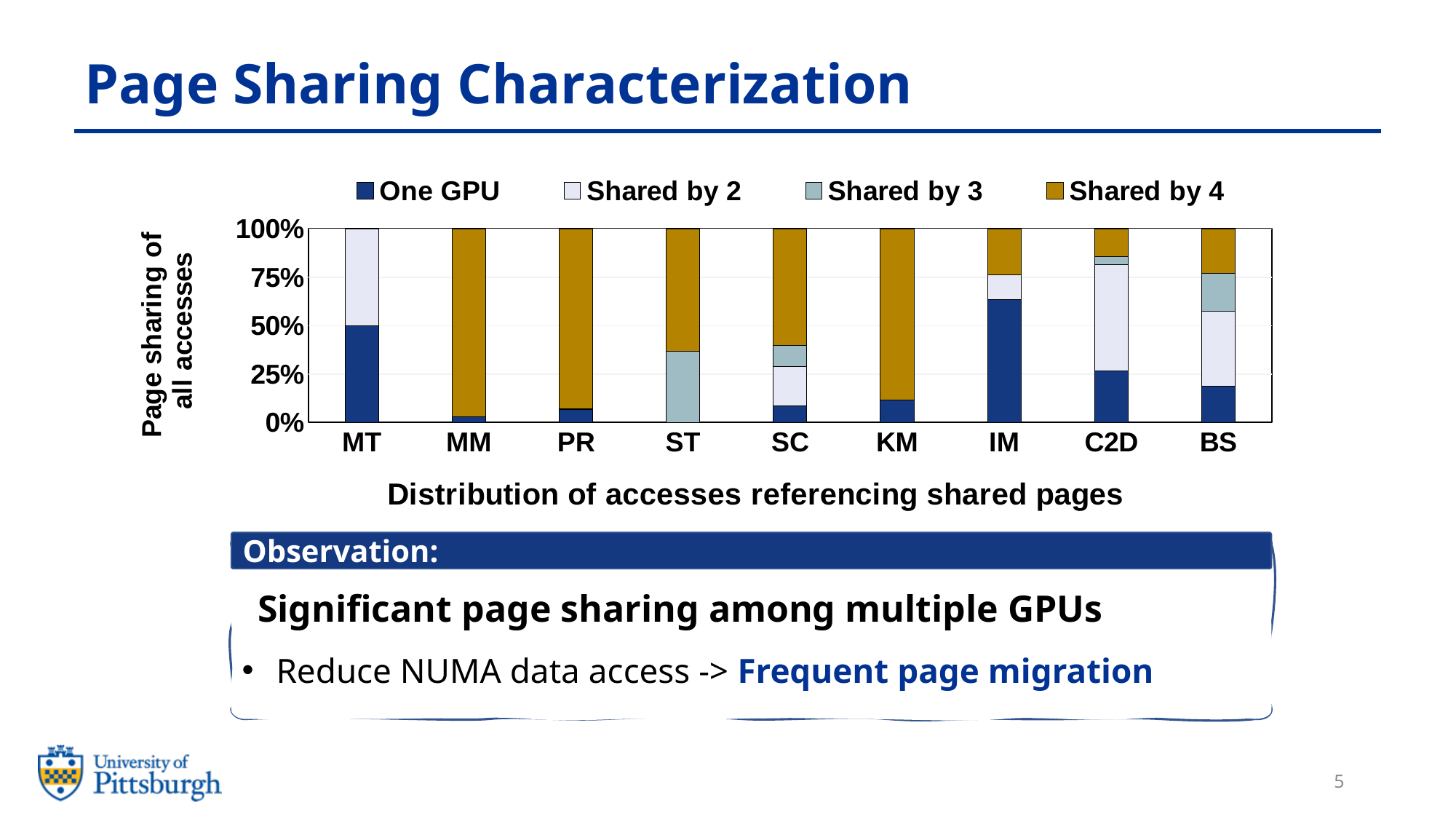
How many series does the chart's legend list? 4 Which has a larger One GPU share, MT or IM? IM What kind of chart is shown on the slide? Stacked bar chart What is the caption printed below the chart's x axis? Distribution of accesses referencing shared pages Which legend entry is shown in gold/orange? Shared by 4 Which category has the largest One GPU share? IM Is the One GPU value for IM greater or less than 50%? greater Is the Shared by 3 value for ST greater or less than 25%? greater Is the Shared by 4 value for KM greater or less than 75%? greater How many categories (benchmarks) are shown on the x axis of the chart? 9 Which has a larger Shared by 4 share, MM or BS? MM